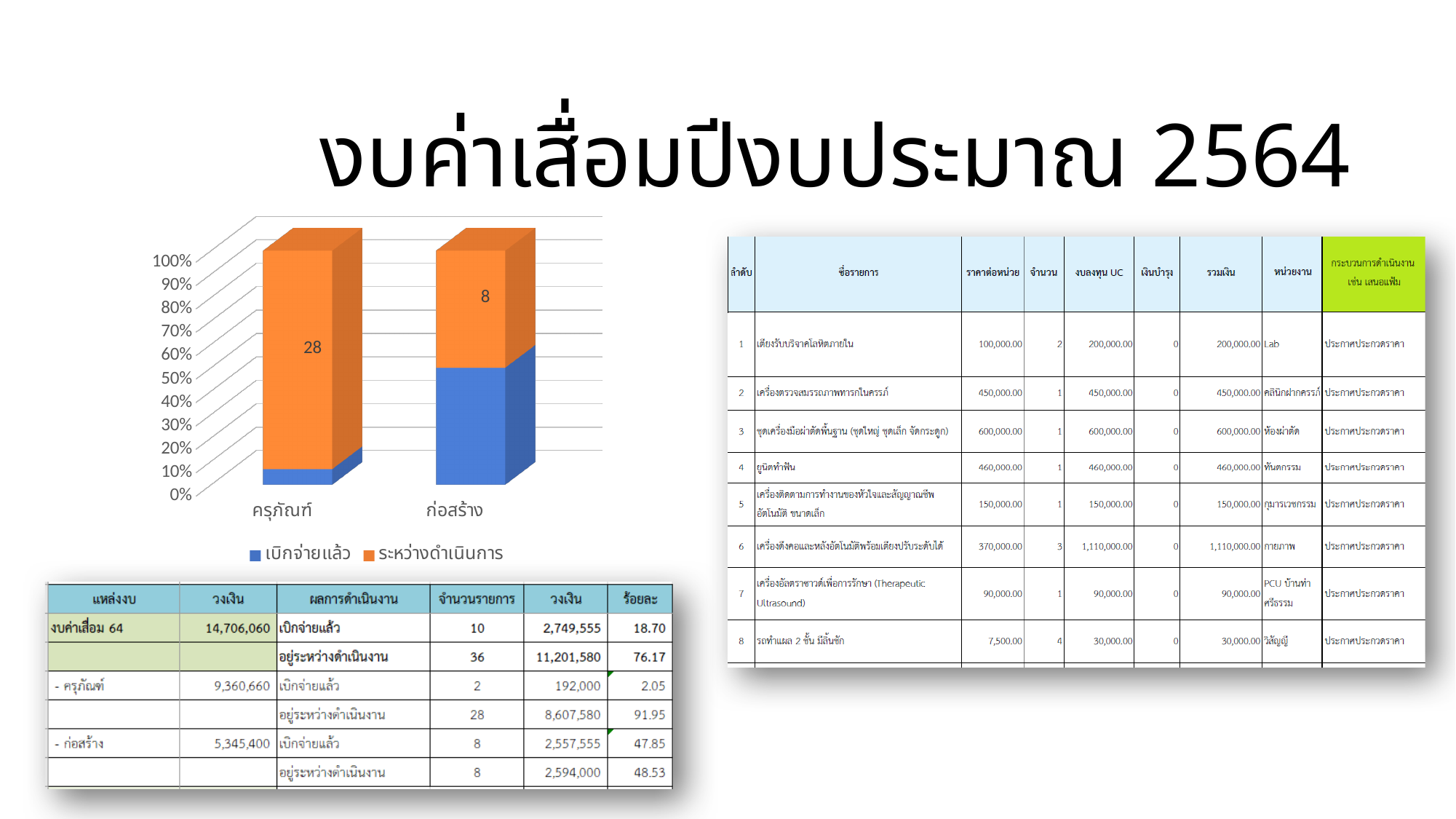
How many series does the chart legend list? 2 What kind of chart is shown on the slide? bar chart Is the เบิกจ่ายแล้ว segment for ครุภัณฑ์ greater or less than 30% of the bar? less Which colour represents the เบิกจ่ายแล้ว series in the chart? blue What is the difference between the labelled ระหว่างดำเนินการ values for ครุภัณฑ์ and ก่อสร้าง? 20 How many categories are shown on the x axis of the chart? 2 What is the data label on the ระหว่างดำเนินการ segment for ก่อสร้าง? 8 Which category has the higher labelled ระหว่างดำเนินการ value, ครุภัณฑ์ or ก่อสร้าง? ครุภัณฑ์ Which colour represents the ระหว่างดำเนินการ series in the chart? orange Which category has the lowest labelled ระหว่างดำเนินการ value? ก่อสร้าง What is the data label on the ระหว่างดำเนินการ segment for ครุภัณฑ์? 28 Is the เบิกจ่ายแล้ว segment for ก่อสร้าง greater or less than 30% of the bar? greater